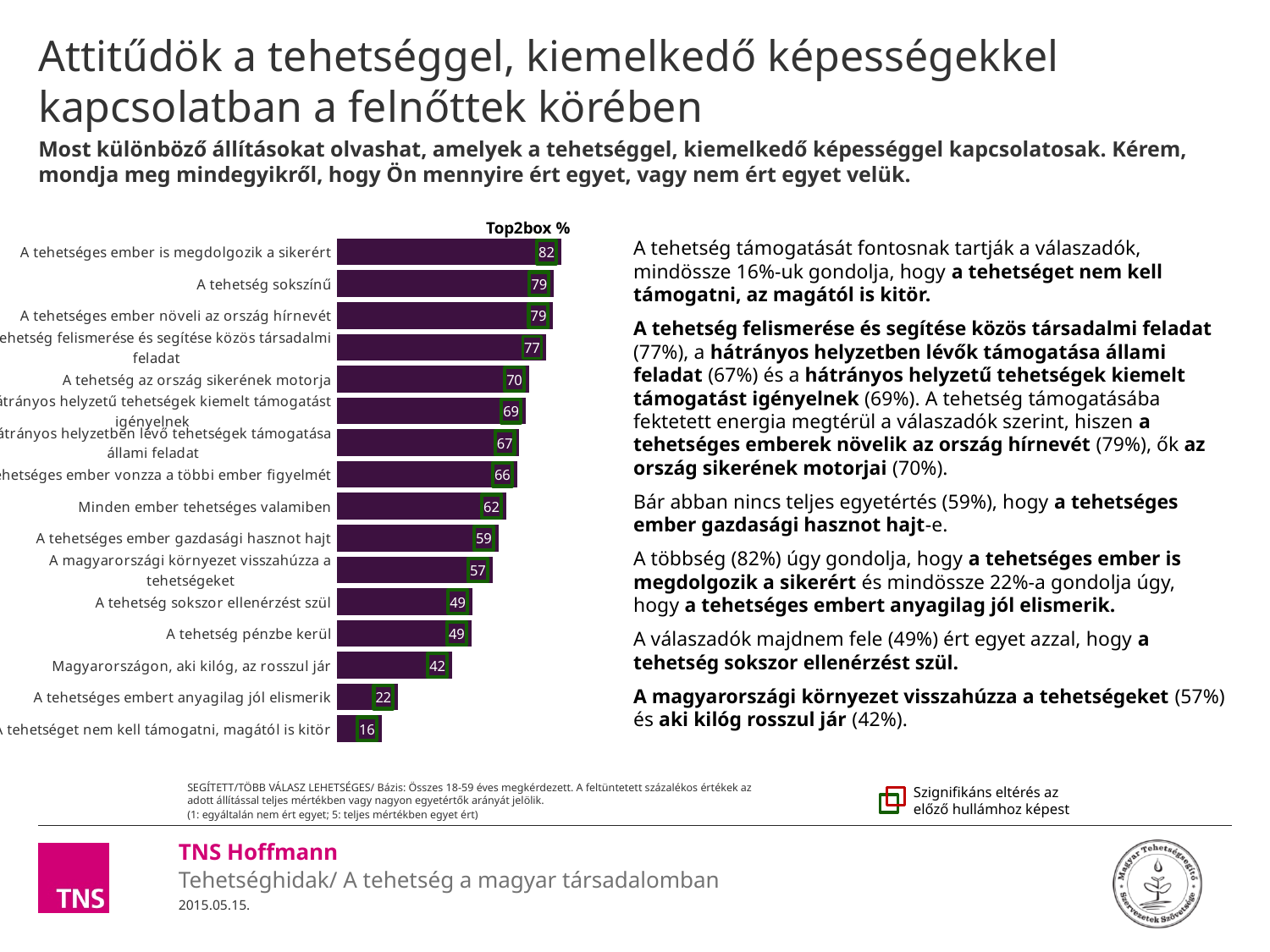
What is the difference between the values for "A tehetséges ember gazdasági hasznot hajt" and "A magyarországi környezet visszahúzza a tehetségeket"? 2 Which statement has the lowest Top2box % value? A tehetséget nem kell támogatni, magától is kitör What is the difference between the values for "A tehetséges ember is megdolgozik a sikerért" and "A tehetséges embert anyagilag jól elismerik"? 60 Which has a higher value: "A tehetség pénzbe kerül" or "Magyarországon, aki kilóg, az rosszul jár"? A tehetség pénzbe kerül Which statement has the highest Top2box % value? A tehetséges ember is megdolgozik a sikerért What is the Top2box % value for "A tehetséges embert anyagilag jól elismerik"? 22 What is the Top2box % value for "Minden ember tehetséges valamiben"? 62 What is the Top2box % value for "A tehetség sokszínű"? 79 What is the Top2box % value for "A tehetség az ország sikerének motorja"? 70 What is the Top2box % value for "A tehetséges ember is megdolgozik a sikerért"? 82 How many statements (bars) are shown in the chart? 16 What type of chart is shown on the slide? Bar chart